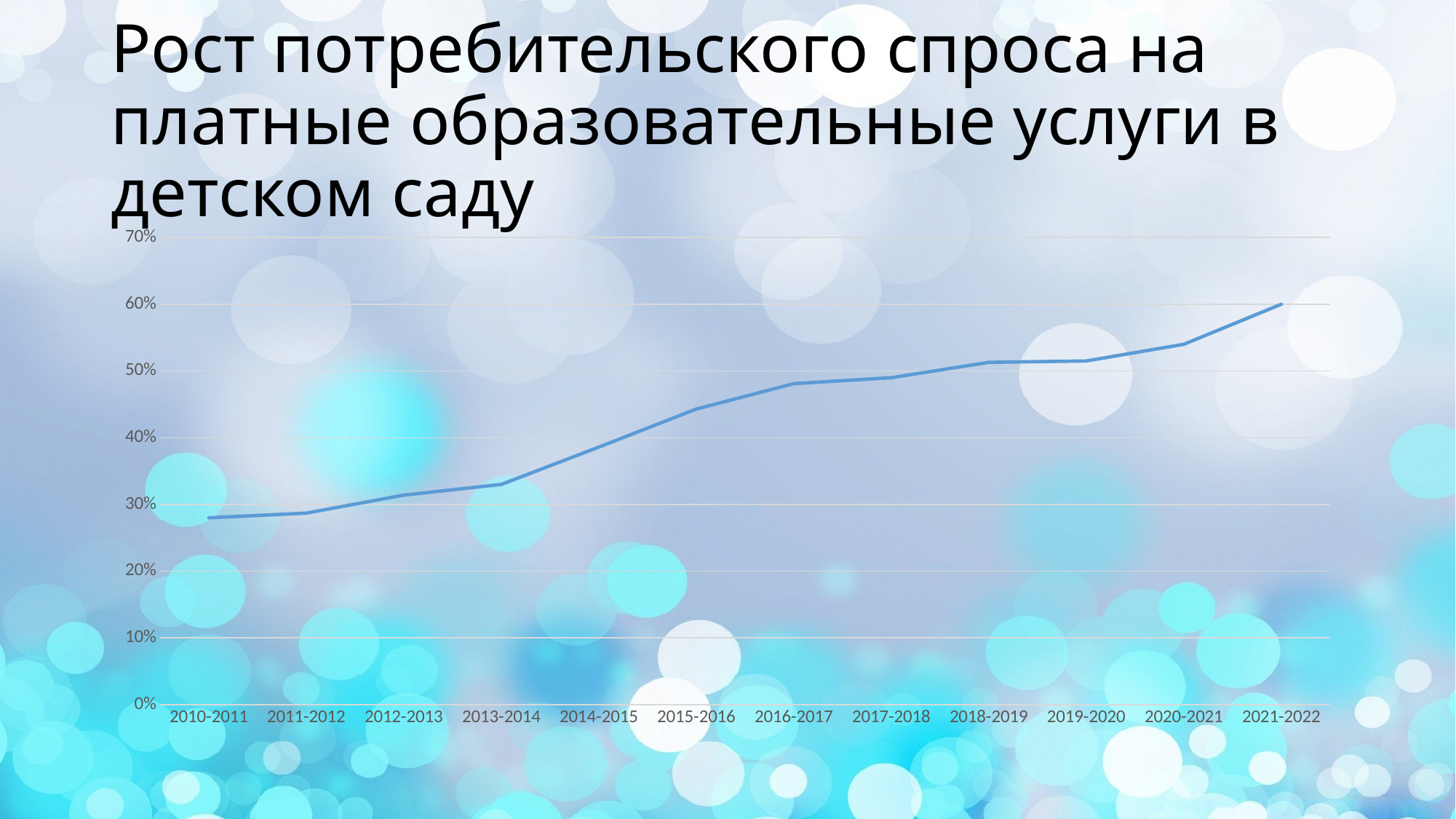
Which is larger, the value for 2015-2016 or the value for 2012-2013? 2015-2016 Is the value for 2016-2017 greater or less than 50%? less Which is larger, the value for 2021-2022 or the value for 2010-2011? 2021-2022 Is the value for 2015-2016 greater or less than 40%? greater What is the title of the slide containing the chart? Рост потребительского спроса на платные образовательные услуги в детском саду Do the values rise or fall along the x axis from 2010-2011 to 2021-2022? rise Which academic year has the highest value? 2021-2022 Which academic year has the lowest value? 2010-2011 Is the value for 2010-2011 greater or less than 30%? less How many academic years (data points) are plotted along the x axis? 12 What kind of chart is shown on the slide? line chart